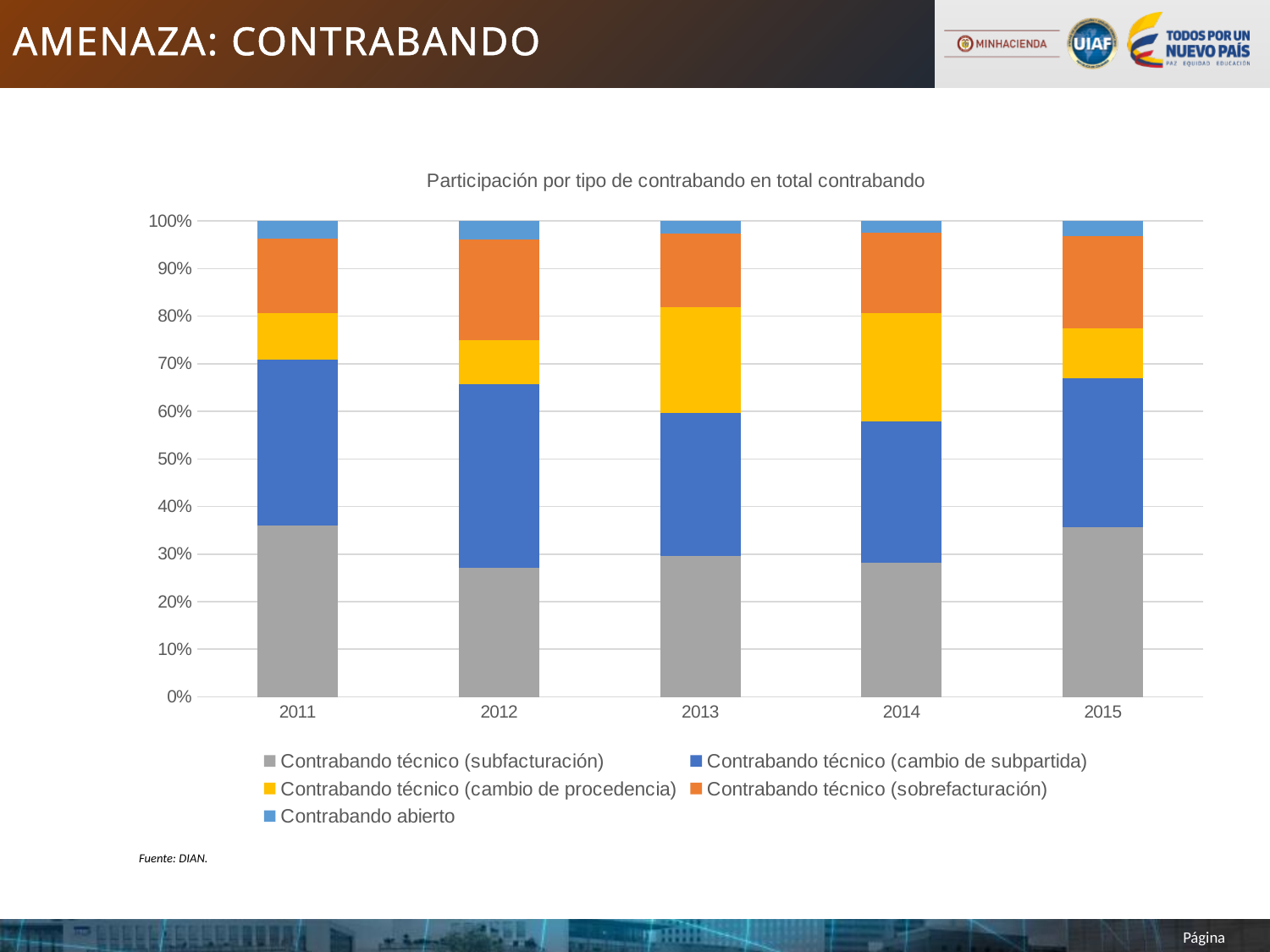
Which is larger: the share of Contrabando técnico (subfacturación) in 2011 or in 2012? 2011 What source is cited below the chart? DIAN What does each stacked bar in the chart total? 100% How many years are shown on the x axis of the chart? 5 What kind of chart is shown on the slide? Stacked bar chart What is the title of the chart? Participación por tipo de contrabando en total contrabando Which year has the largest share of Contrabando técnico (cambio de subpartida)? 2012 Is the share of Contrabando técnico (subfacturación) in 2012 greater or less than 30%? less How many series does the chart legend list? 5 Is the share of Contrabando técnico (subfacturación) in 2015 greater or less than 30%? greater Is the share of Contrabando técnico (subfacturación) in 2011 greater or less than 30%? greater Which is larger: the share of Contrabando técnico (cambio de procedencia) in 2013 or in 2012? 2013